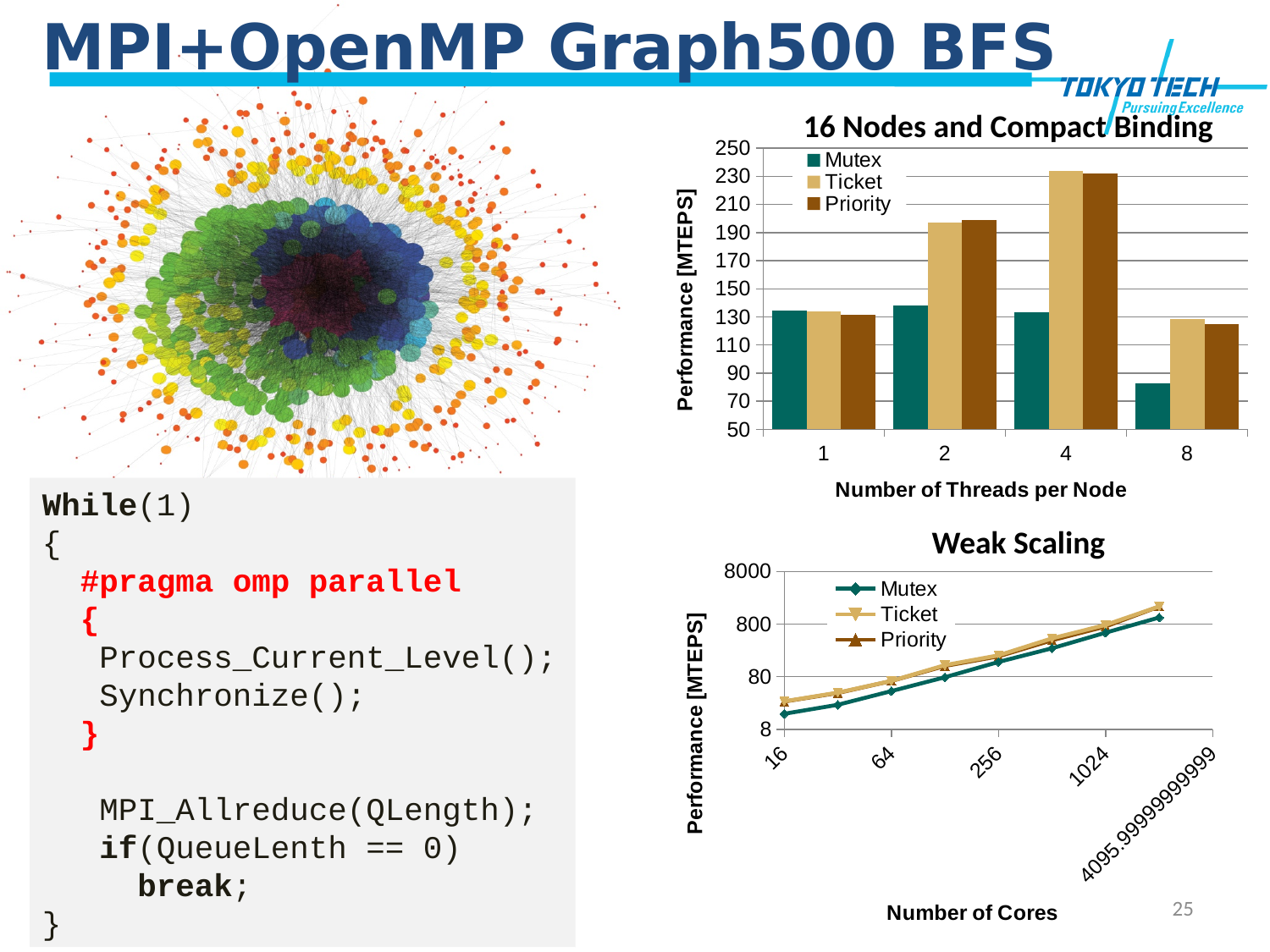
In the 'Weak Scaling' chart, do the values rise or fall as the number of cores increases? rise In the '16 Nodes and Compact Binding' chart, is the Ticket value at 4 threads per node greater or less than 210? greater In the '16 Nodes and Compact Binding' chart, is the Mutex value at 8 threads per node greater or less than 90? less In the 'Weak Scaling' chart, what is the x-axis title? Number of Cores In the '16 Nodes and Compact Binding' chart, how many thread-count categories are shown on the x axis? 4 In the '16 Nodes and Compact Binding' chart, how many series does the legend list? 3 In the '16 Nodes and Compact Binding' chart, at 8 threads per node, which is larger: Mutex or Ticket? Ticket In the '16 Nodes and Compact Binding' chart, what kind of chart is shown? bar chart In the '16 Nodes and Compact Binding' chart, is the Priority value at 2 threads per node greater or less than 190? greater In the 'Weak Scaling' chart, what kind of chart is shown? line chart In the '16 Nodes and Compact Binding' chart, at which number of threads per node is the Mutex bar lowest? 8 In the '16 Nodes and Compact Binding' chart, at which number of threads per node is the Ticket bar highest? 4